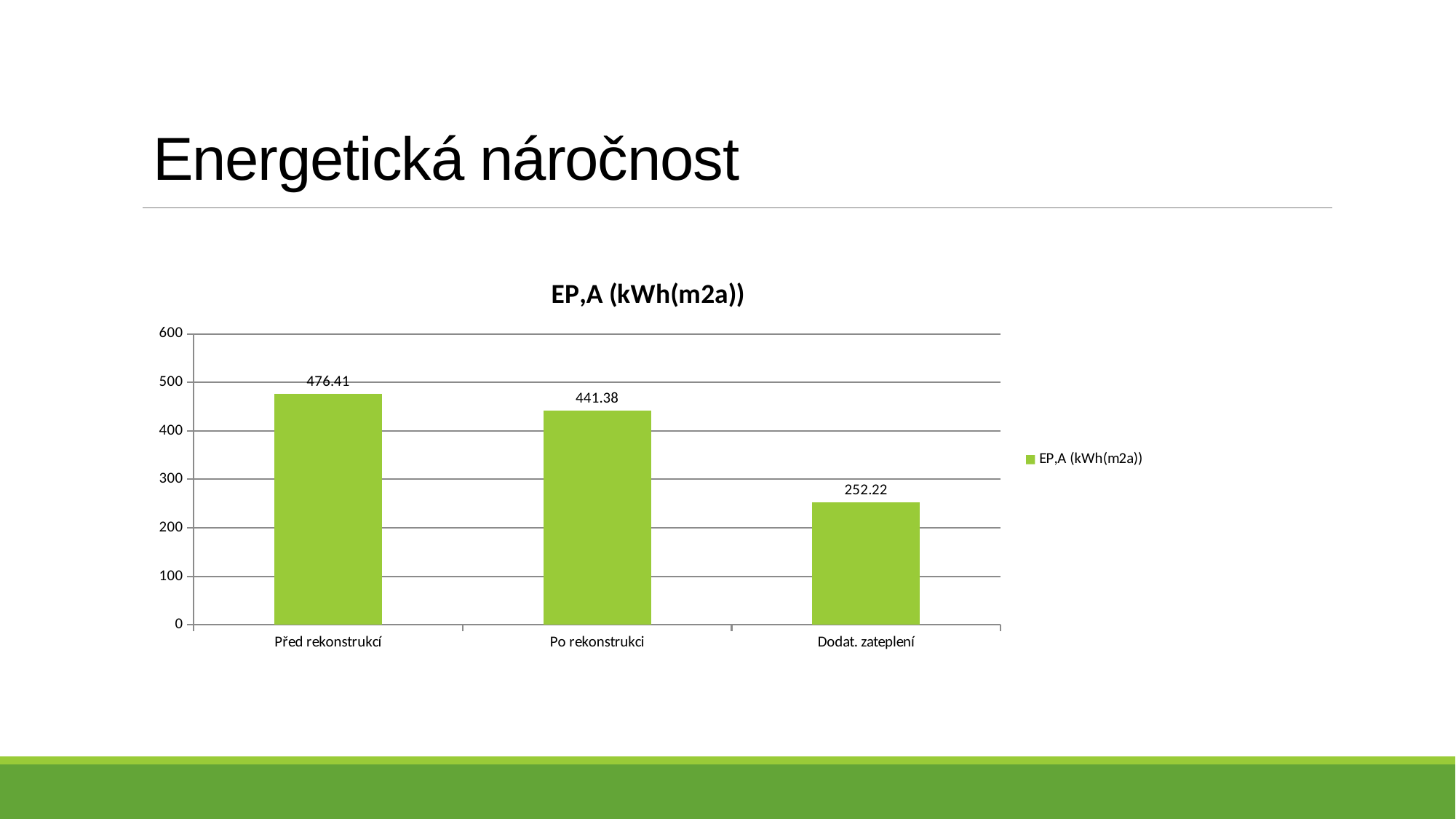
How many categories are shown on the x axis? 3 What is the value for Před rekonstrukcí? 476.41 What is the difference between the values for Před rekonstrukcí and Po rekonstrukci? 35.03 Which category has the lowest value? Dodat. zateplení What is the value for Po rekonstrukci? 441.38 What is the title of the chart? EP,A (kWh(m2a)) What is the difference between the values for Po rekonstrukci and Dodat. zateplení? 189.16 What kind of chart is shown on the slide? bar chart Is the value for Dodat. zateplení greater or less than 300? less Which is larger, the value for Po rekonstrukci or the value for Dodat. zateplení? Po rekonstrukci What is the value for Dodat. zateplení? 252.22 Which category has the highest value? Před rekonstrukcí